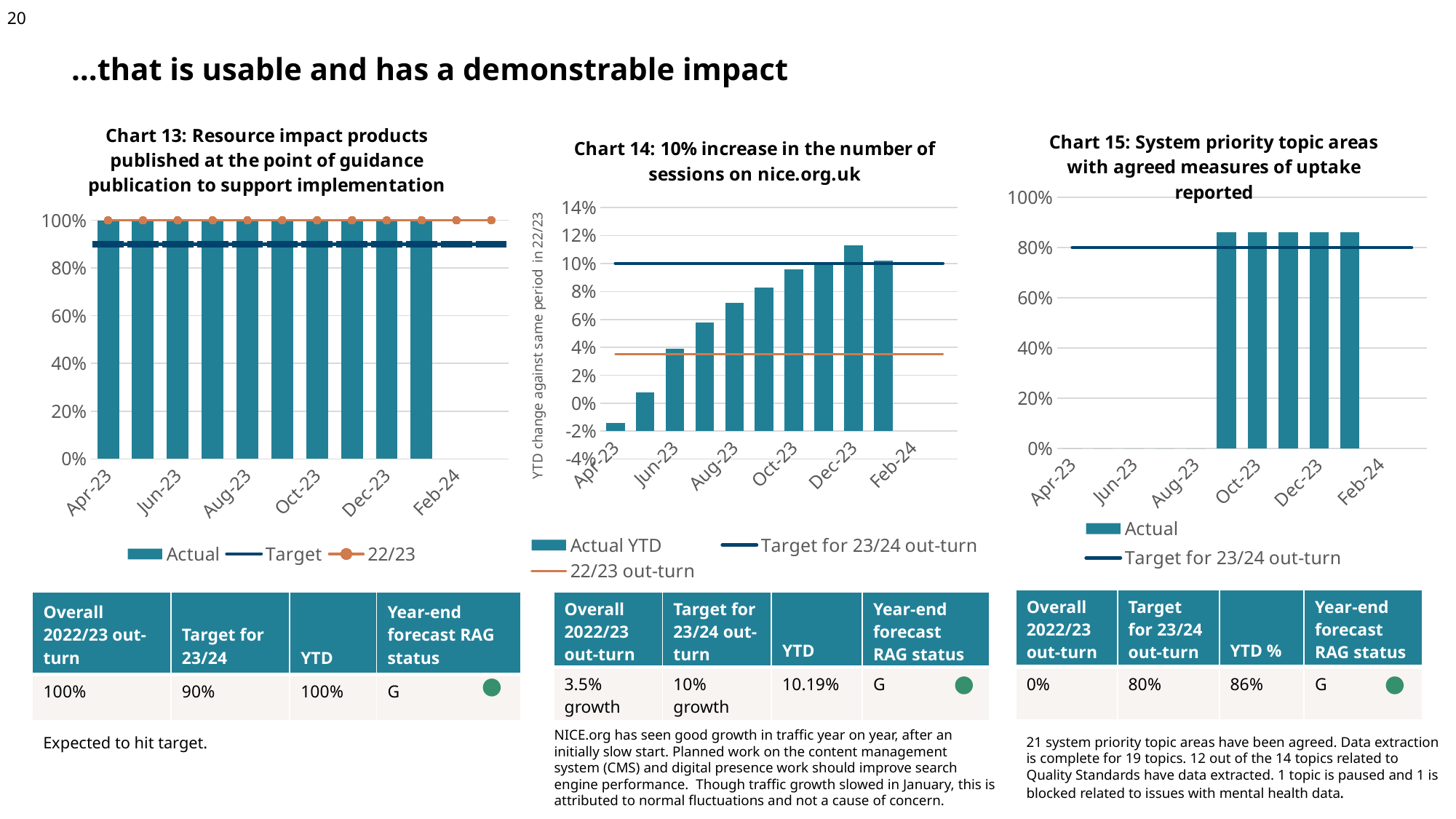
In Chart 15, is the Actual value for Oct-23 greater or less than 80%? greater How many series does the legend of Chart 15 list? 2 In Chart 14, which month has the highest Actual YTD bar? Dec-23 In Chart 14, do the Actual YTD bars generally rise or fall from Apr-23 to Dec-23? Rise In Chart 14, which month has the lowest Actual YTD bar? Apr-23 In Chart 14, is the Actual YTD value for Aug-23 greater or less than 6%? greater In Chart 13, what is the Actual value for Apr-23? 100% In Chart 14, is the Actual YTD value for Apr-23 greater or less than 0%? less How many series does the legend of Chart 14 list? 3 In Chart 14, which is larger, the Actual YTD bar for Dec-23 or for Jan-24? Dec-23 What kind of chart is Chart 14: 10% increase in the number of sessions on nice.org.uk? Combination bar and line chart In Chart 15, how many Actual bars are plotted? 5